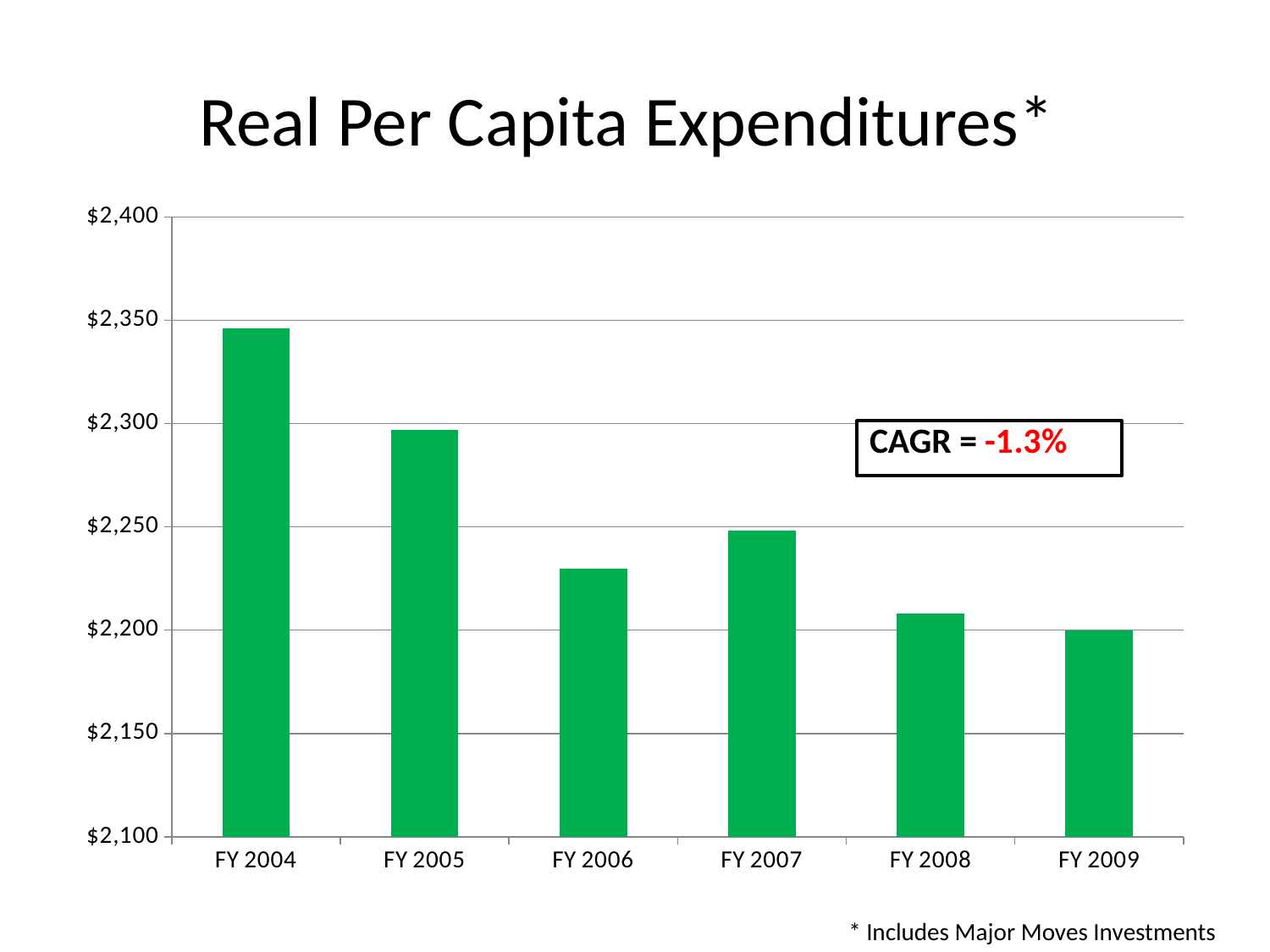
Is the value for FY 2007 greater or less than $2,200? greater Is the value for FY 2005 greater or less than $2,250? greater How many fiscal years are plotted in the chart? 6 Is the value for FY 2004 greater or less than $2,300? greater What CAGR is shown in the box on the chart? -1.3% Do real per capita expenditures generally rise or fall from FY 2004 to FY 2009? fall What is the title of the chart? Real Per Capita Expenditures* Which fiscal year has the highest real per capita expenditures? FY 2004 Which fiscal year has the lowest real per capita expenditures? FY 2009 What kind of chart is shown on the slide? bar chart Which is larger, the value for FY 2006 or the value for FY 2007? FY 2007